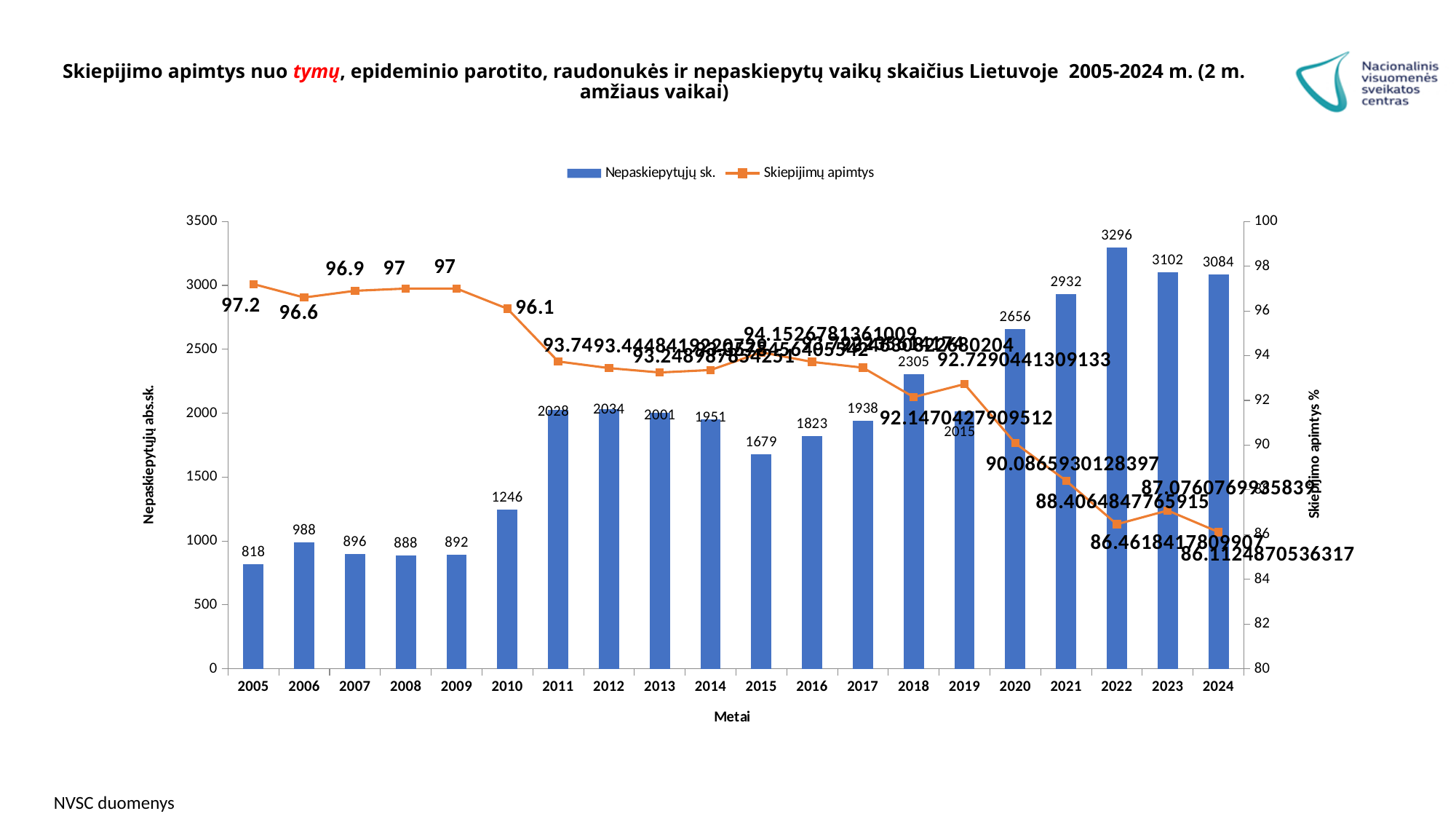
What is the value of Nepaskiepytųjų sk. for 2005? 818 How many series does the legend list? 2 How many years are shown on the x axis? 20 What is the Skiepijimų apimtys value for 2010? 96.1 Which year has the lowest Nepaskiepytųjų sk. value? 2005 Does the Skiepijimų apimtys line generally rise or fall from 2005 to 2024? fall What is the value of Nepaskiepytųjų sk. for 2022? 3296 Which is larger, the Nepaskiepytųjų sk. value for 2011 or for 2015? 2011 Is the Nepaskiepytųjų sk. value for 2020 greater or less than 2500? greater Which year has the highest Nepaskiepytųjų sk. value? 2022 What is the difference in Nepaskiepytųjų sk. between 2022 and 2021? 364 What is the Skiepijimų apimtys value for 2005? 97.2